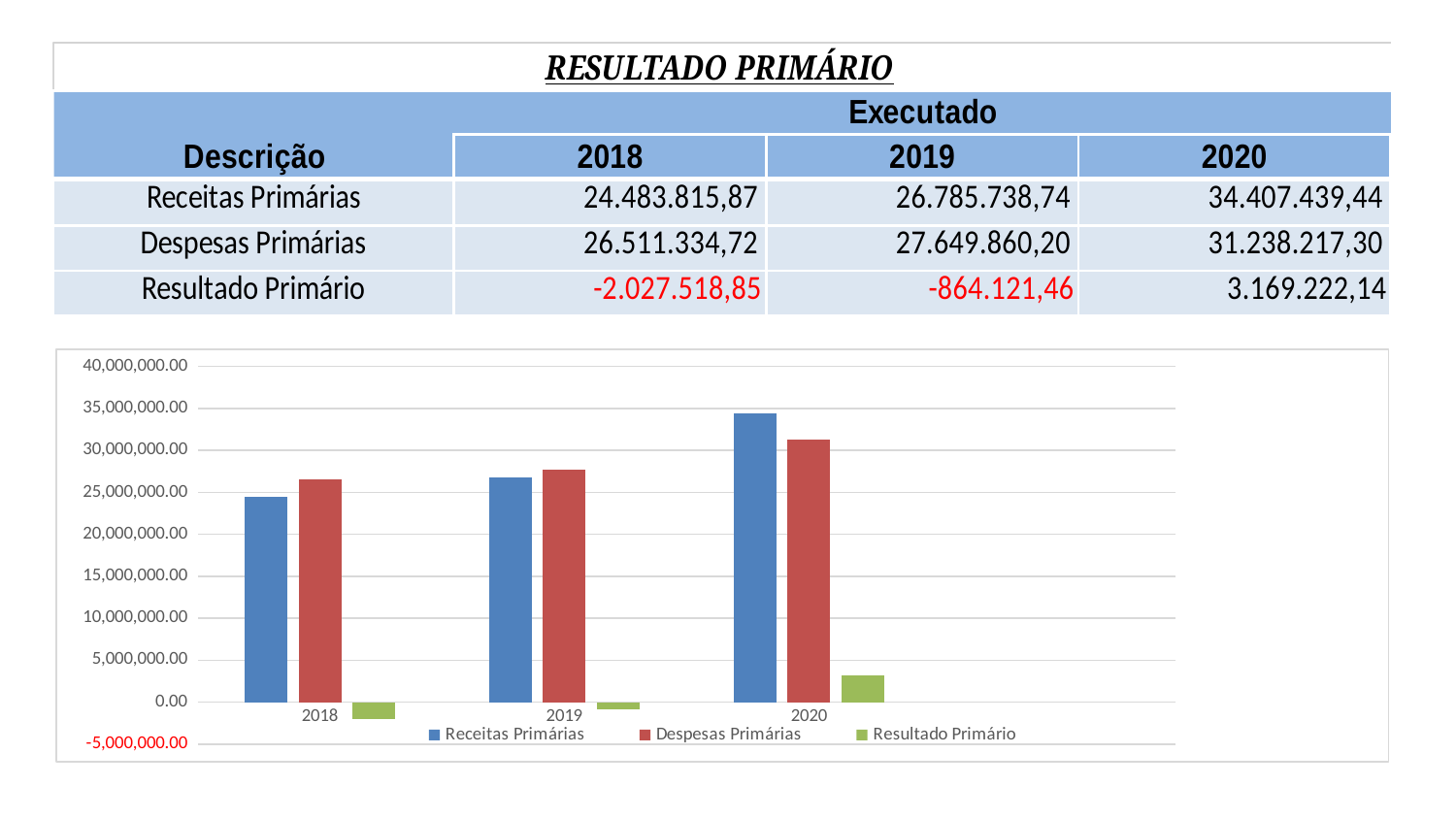
Is the Receitas Primárias bar for 2020 greater or less than 30,000,000.00? greater In 2020, which is larger, Receitas Primárias or Despesas Primárias? Receitas Primárias In 2018, which is larger, Receitas Primárias or Despesas Primárias? Despesas Primárias Is the Despesas Primárias bar for 2018 greater or less than 30,000,000.00? less How many series does the chart legend list? 3 What is the value of Resultado Primário for 2020 as printed on the slide? 3.169.222,14 What kind of chart is shown on the slide? bar chart Which year has the highest Receitas Primárias bar? 2020 Which series is shown in green in the chart? Resultado Primário Do the Receitas Primárias bars rise or fall from 2018 to 2020? rise How many years are shown on the x axis of the chart? 3 Which year has the lowest Receitas Primárias bar? 2018